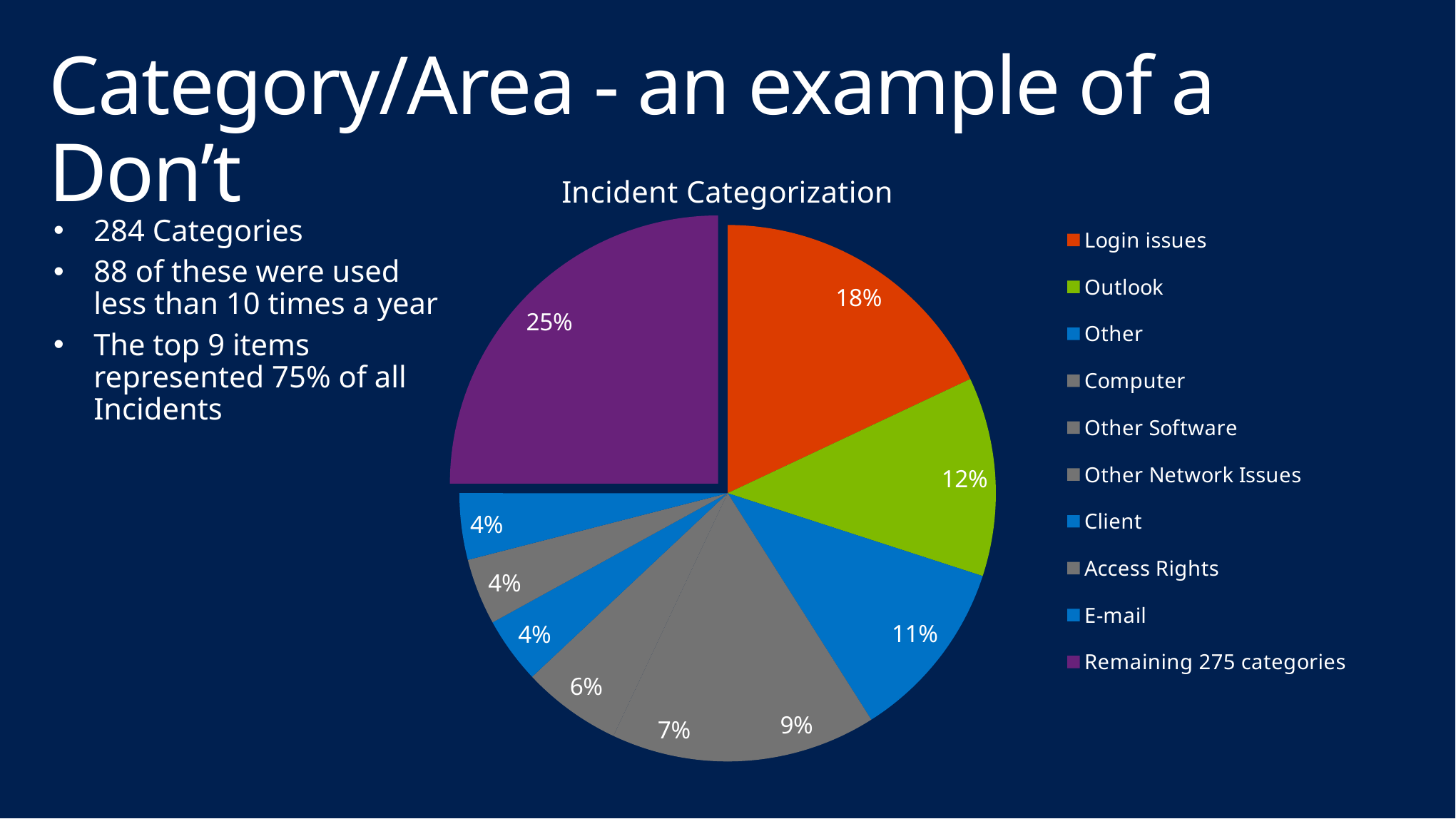
What is the difference in percentage points between Login issues and Outlook? 6% Which is larger, the Login issues slice or the Other slice? Login issues What percentage is shown for the Remaining 275 categories slice? 25% What percentage is shown for the Other category? 11% What type of chart is shown on the slide? pie chart What share of the pie does Outlook represent? 12% What is the title of the chart? Incident Categorization Which slice of the pie is the largest? Remaining 275 categories What percentage of incidents is attributed to Login issues? 18% What percentage is shown for Computer? 9% How many slices does the pie chart have? 10 How many entries does the legend list? 10